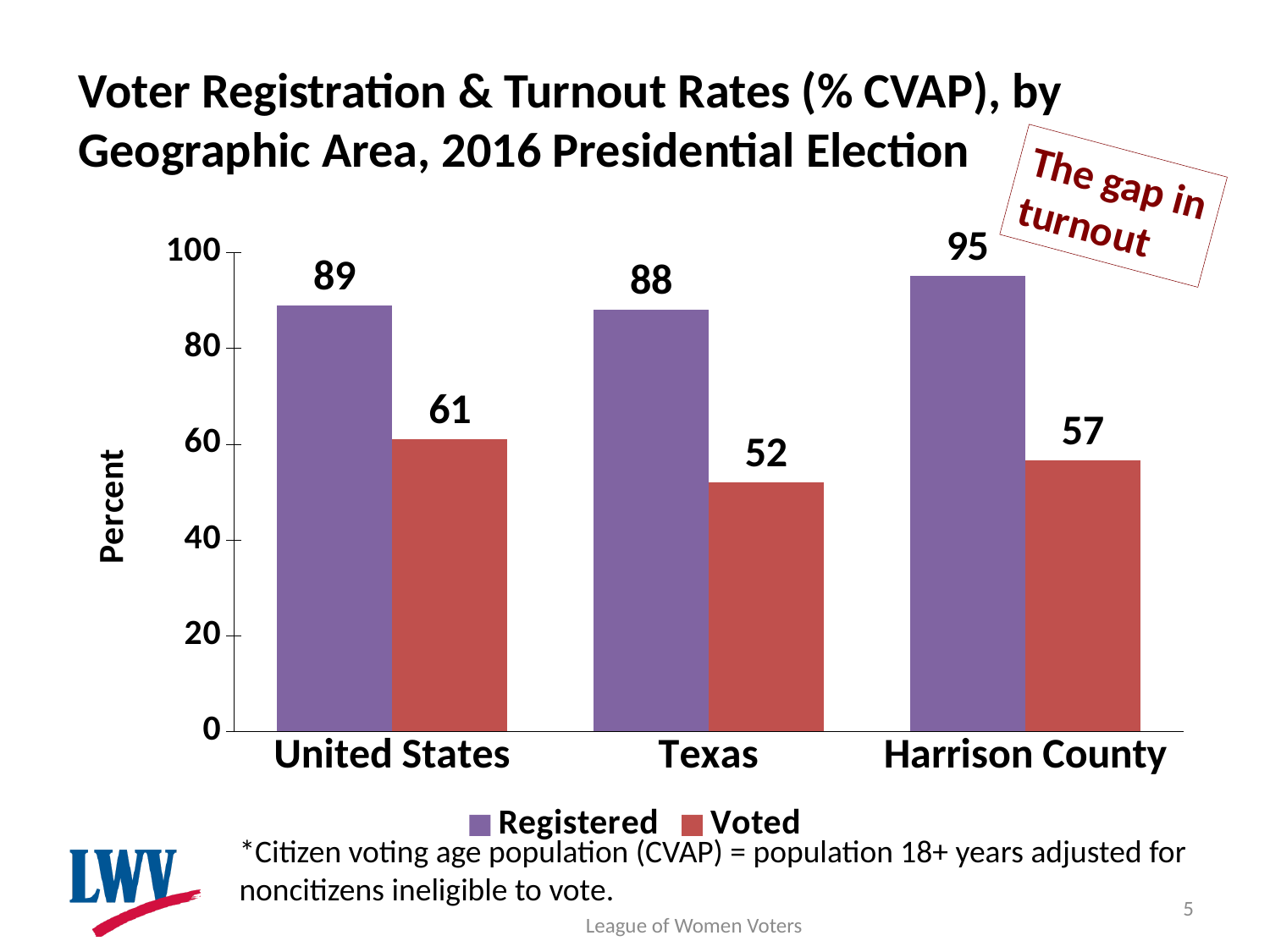
Which geographic area has the lowest Voted value? Texas What is the label on the vertical axis? Percent Which is larger, the Registered value for the United States or the Registered value for Texas? United States What is the Voted value for Harrison County? 57 Which geographic area has the highest Registered value? Harrison County How many series does the legend list? 2 How many geographic areas are shown on the x axis? 3 What is the Registered value for Texas? 88 What is the Voted value for the United States? 61 What kind of chart is shown on the slide? Bar chart What is the difference between the Registered and Voted values for Texas? 36 What is the difference between the Voted values for the United States and Harrison County? 4